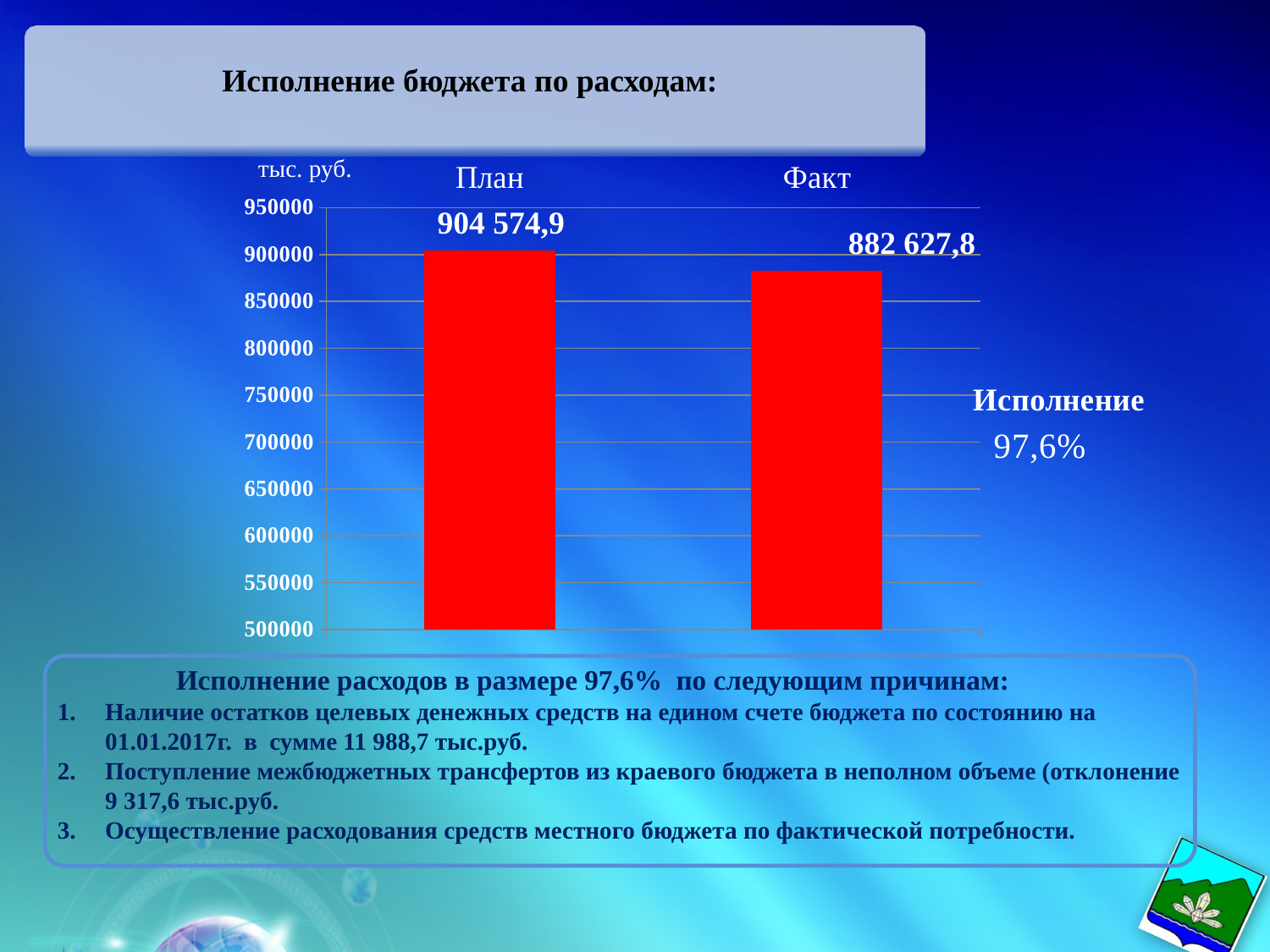
What is the value of the Факт bar? 882 627,8 What is the difference between the План and Факт values? 21 947,1 Is the value for Факт greater or less than 900000? less What kind of chart is shown on the slide? bar chart What execution percentage (Исполнение) is shown next to the chart? 97,6% Which bar is the lowest on the chart? Факт What is the lowest value shown on the vertical axis? 500000 How many bars are plotted on the chart? 2 Which bar is higher, План or Факт? План What unit of measurement is indicated above the vertical axis? тыс. руб. Is the value for План greater or less than 900000? greater What is the value of the План bar? 904 574,9